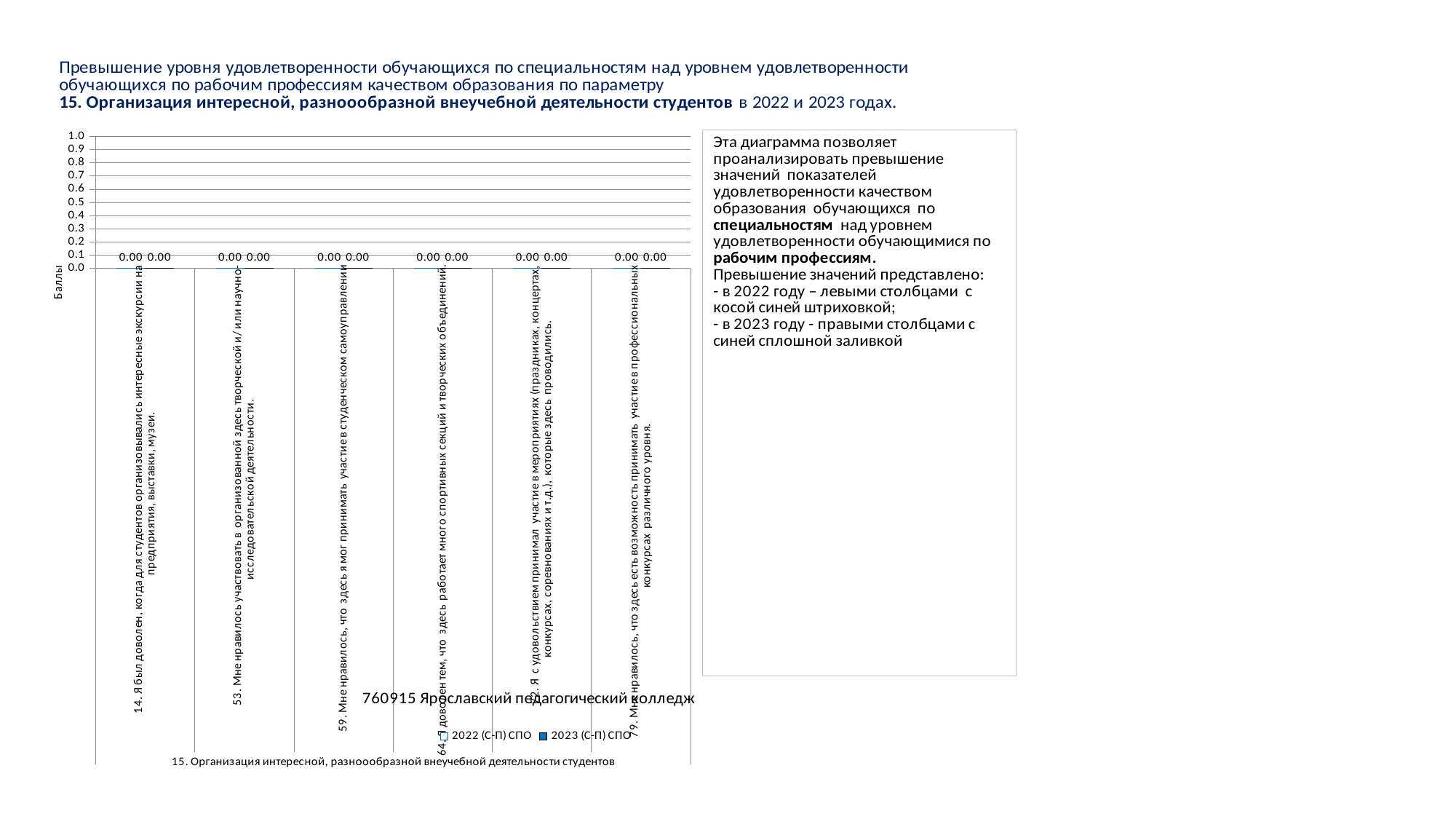
What is the label of the vertical axis of the chart? Баллы Is the value for the 2023 (С-П) СПО series for category 72 (Я с удовольствием принимал участие в мероприятиях...) greater or less than 0.5? less How many series does the legend list? 2 What is the value for the 2023 (С-П) СПО series for category 79 (Мне нравилось, что здесь есть возможность принимать участие в профессиональных конкурсах...)? 0.00 How many categories are shown on the x axis of the chart? 6 What is the value for the 2023 (С-П) СПО series for category 64 (Я доволен тем, что здесь работает много спортивных секций и творческих объединений)? 0.00 What is the value for the 2022 (С-П) СПО series for category 59 (Мне нравилось, что здесь я мог принимать участие в студенческом самоуправлении)? 0.00 What kind of chart is shown on the slide? Bar chart What are the two series names listed in the chart legend? 2022 (С-П) СПО and 2023 (С-П) СПО What is the value for the 2022 (С-П) СПО series for category 14 (Я был доволен, когда для студентов организовывались интересные экскурсии...)? 0.00 What is the difference between the 2022 (С-П) СПО and 2023 (С-П) СПО values for category 53 (Мне нравилось участвовать в организованной здесь творческой и/или научно-исследовательской деятельности)? 0.00 Do the values for the 2022 (С-П) СПО series rise, fall, or stay the same across the categories? Stay the same